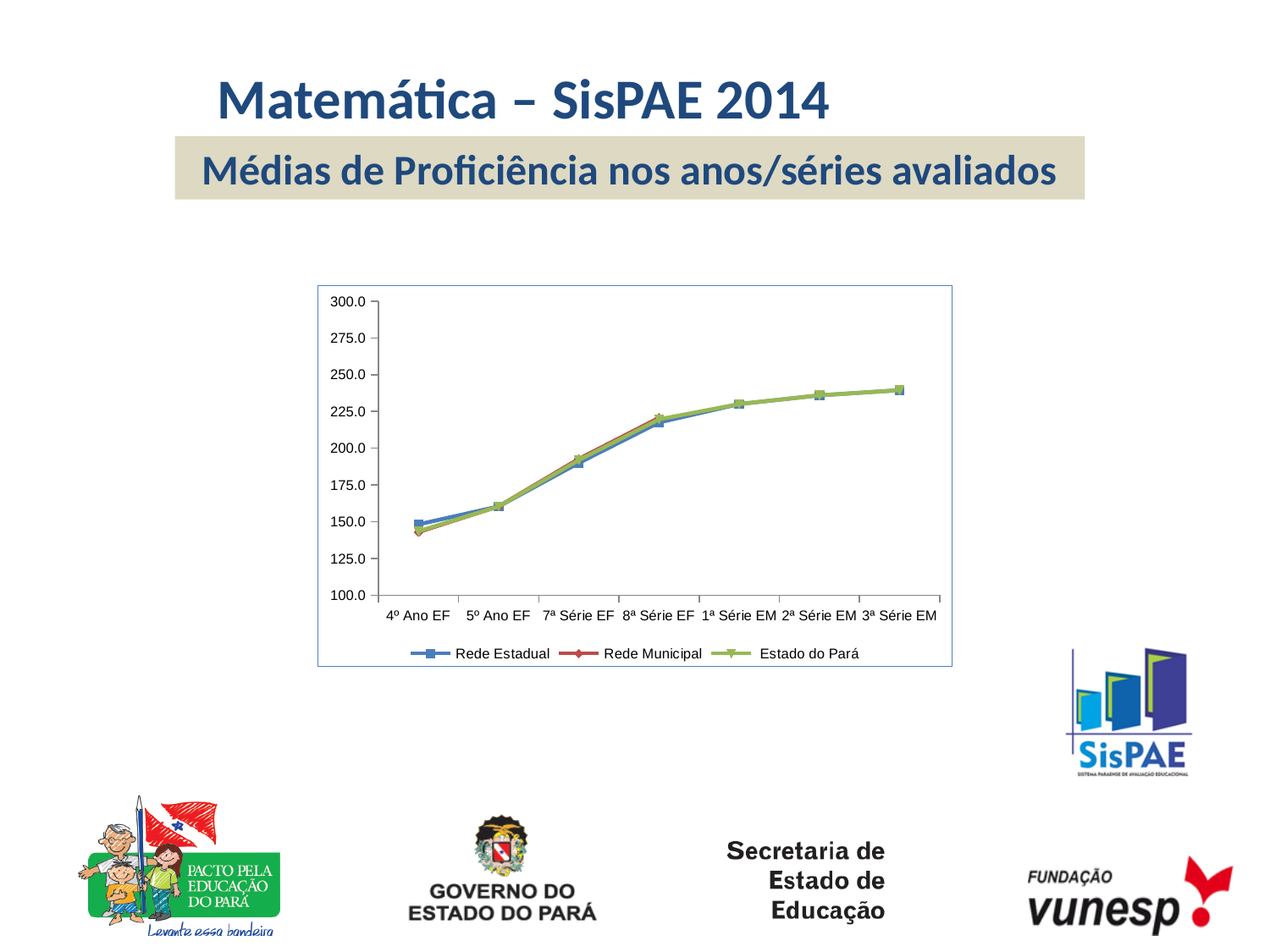
How many years/series (categories) are plotted along the x axis? 7 Which series is shown in green in the legend? Estado do Pará Is the value for Rede Municipal at 4º Ano EF greater or less than 150? less Is the value for Estado do Pará at 3ª Série EM greater or less than 250? less Is the value for Rede Estadual at 8ª Série EF greater or less than 200? greater What kind of chart is shown on the slide? line chart Do the proficiency averages rise or fall from 4º Ano EF to 3ª Série EM? rise How many series does the legend list? 3 Which category has the lowest proficiency averages? 4º Ano EF What subject and year does the slide title refer to? Matemática – SisPAE 2014